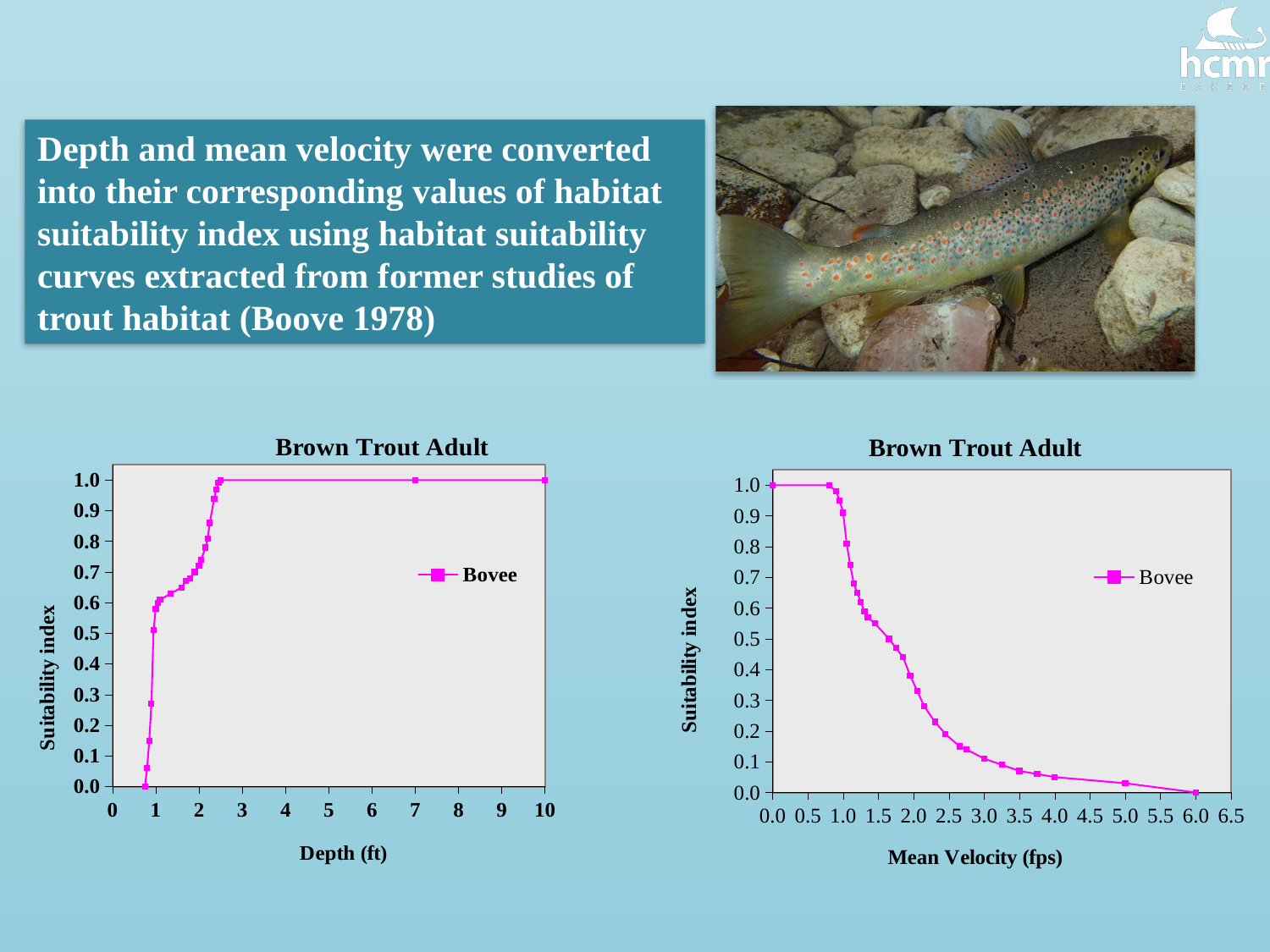
In the left chart (Depth (ft)), what is the suitability index at a depth of 10 ft? 1.0 What is the name of the series shown in the legend of the left chart (Depth (ft))? Bovee In the right chart (Mean Velocity (fps)), what is the suitability index at a mean velocity of 0.0 fps? 1.0 In the left chart (Depth (ft)), is the suitability index at a depth of 5 ft greater or less than 0.5? greater In the right chart (Mean Velocity (fps)), do the suitability index values rise or fall as mean velocity increases? fall What is the x-axis label of the right chart? Mean Velocity (fps) In the right chart (Mean Velocity (fps)), is the suitability index at 2.0 fps greater or less than 0.5? less What kind of chart is the left chart (Depth (ft) on the x axis)? line chart In the left chart (Depth (ft)), do the suitability index values rise or fall as depth increases from 0 to 3 ft? rise In the right chart (Mean Velocity (fps)), what is the suitability index at a mean velocity of 6.0 fps? 0.0 How many series does the legend of the right chart (Mean Velocity (fps)) list? 1 In the right chart (Mean Velocity (fps)), which has the larger suitability index: a mean velocity of 1.0 fps or 3.0 fps? 1.0 fps